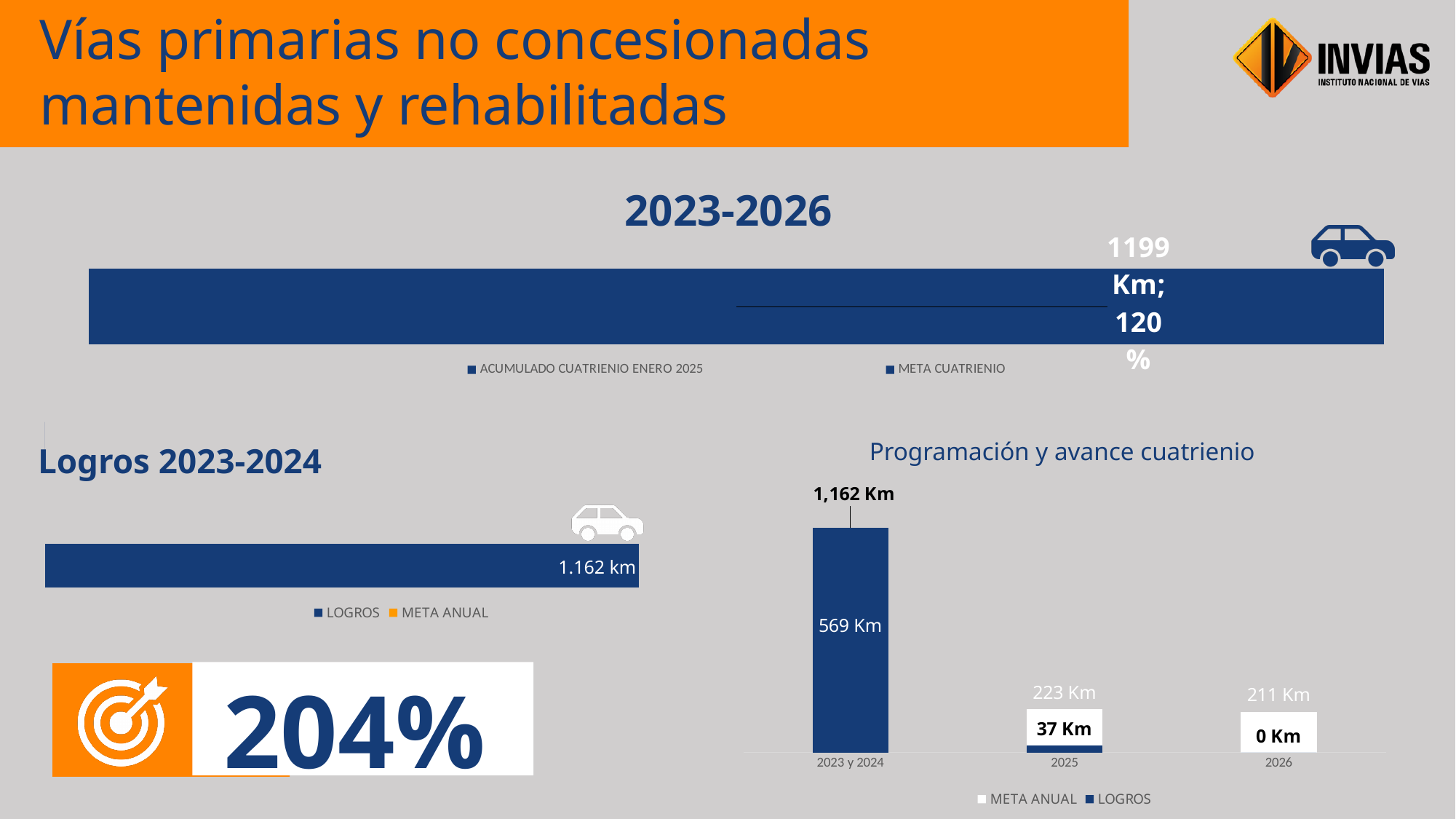
In the 'Programación y avance cuatrienio' chart, what value is printed above the 2026 bar? 211 Km In the 'Programación y avance cuatrienio' chart, which category has the tallest bar? 2023 y 2024 In the 'Programación y avance cuatrienio' chart, what value is printed in the white box for 2026? 0 Km What kind of chart is the '2023-2026' chart at the top of the slide? Bar chart In the 'Programación y avance cuatrienio' chart, how many categories are shown on the x axis? 3 In the 'Programación y avance cuatrienio' chart, what value is printed inside the dark blue bar for '2023 y 2024'? 569 Km In the 'Programación y avance cuatrienio' chart, what value is printed in the white box for 2025? 37 Km In the 'Programación y avance cuatrienio' chart, what value is printed at the top of the '2023 y 2024' bar? 1,162 Km In the '2023-2026' chart at the top of the slide, what label is printed at the end of the bar? 1199 Km; 120 % In the 'Logros 2023-2024' chart, what value is printed on the bar? 1.162 km In the 'Programación y avance cuatrienio' chart, how many series does the legend list? 2 In the 'Programación y avance cuatrienio' chart, what value is printed above the 2025 bar? 223 Km